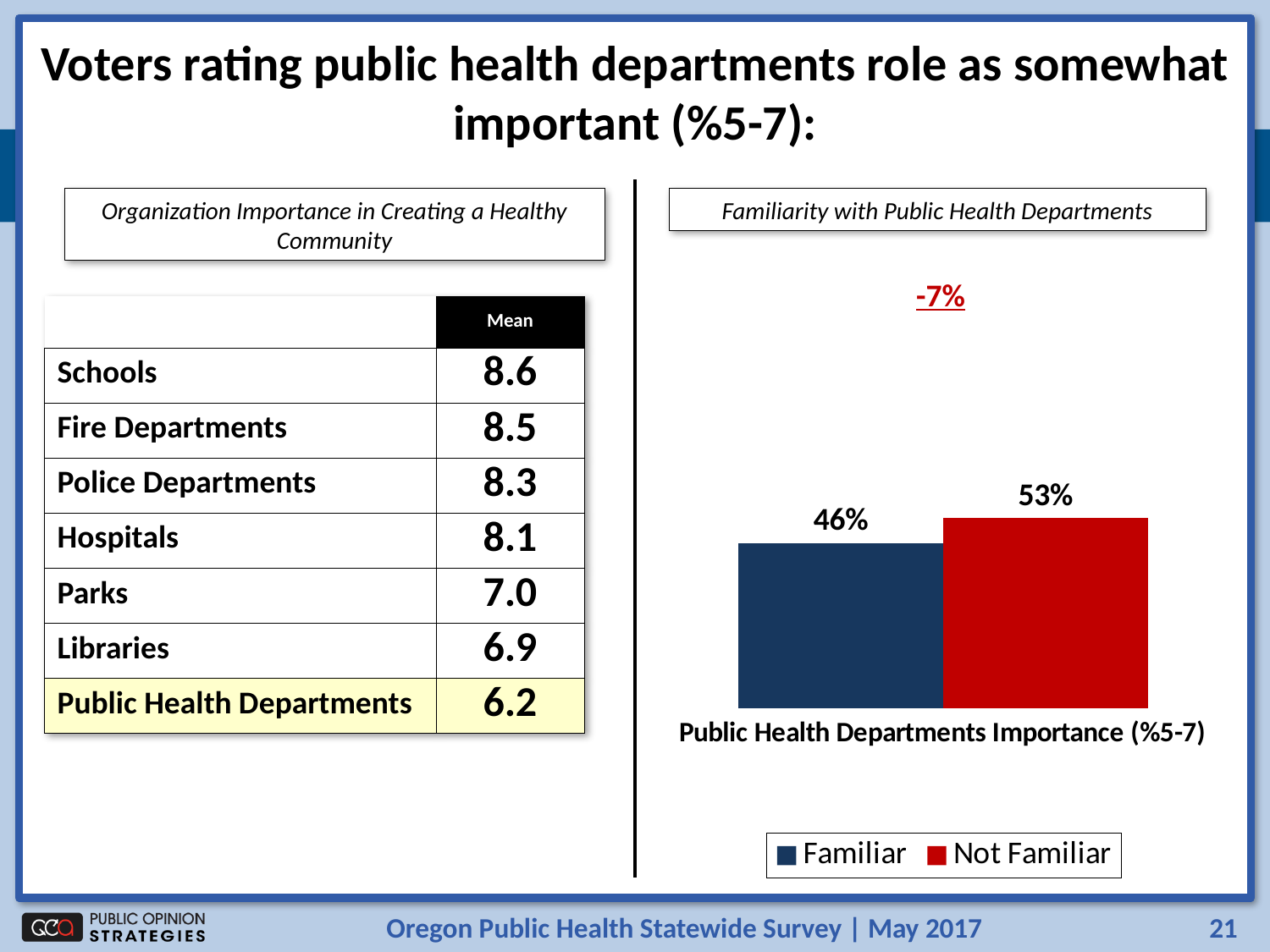
In the 'Familiarity with Public Health Departments' chart, what colour is the Not Familiar bar? red What is the category label on the x axis of the 'Familiarity with Public Health Departments' chart? Public Health Departments Importance (%5-7) In the 'Familiarity with Public Health Departments' chart, what is the difference between the Not Familiar and Familiar values? 7% In the 'Familiarity with Public Health Departments' chart, what is the value for Familiar? 46% How many series does the legend of the 'Familiarity with Public Health Departments' chart list? 2 What kind of chart is shown under the heading 'Familiarity with Public Health Departments'? bar chart In the 'Familiarity with Public Health Departments' chart, is the value for Familiar larger or smaller than the value for Not Familiar? smaller In the 'Familiarity with Public Health Departments' chart, which series has the lower value? Familiar What difference figure is printed in red above the bars in the 'Familiarity with Public Health Departments' chart? -7% In the 'Familiarity with Public Health Departments' chart, which series has the higher value? Not Familiar In the 'Familiarity with Public Health Departments' chart, what is the value for Not Familiar? 53% How many categories are shown on the x axis of the 'Familiarity with Public Health Departments' chart? 1